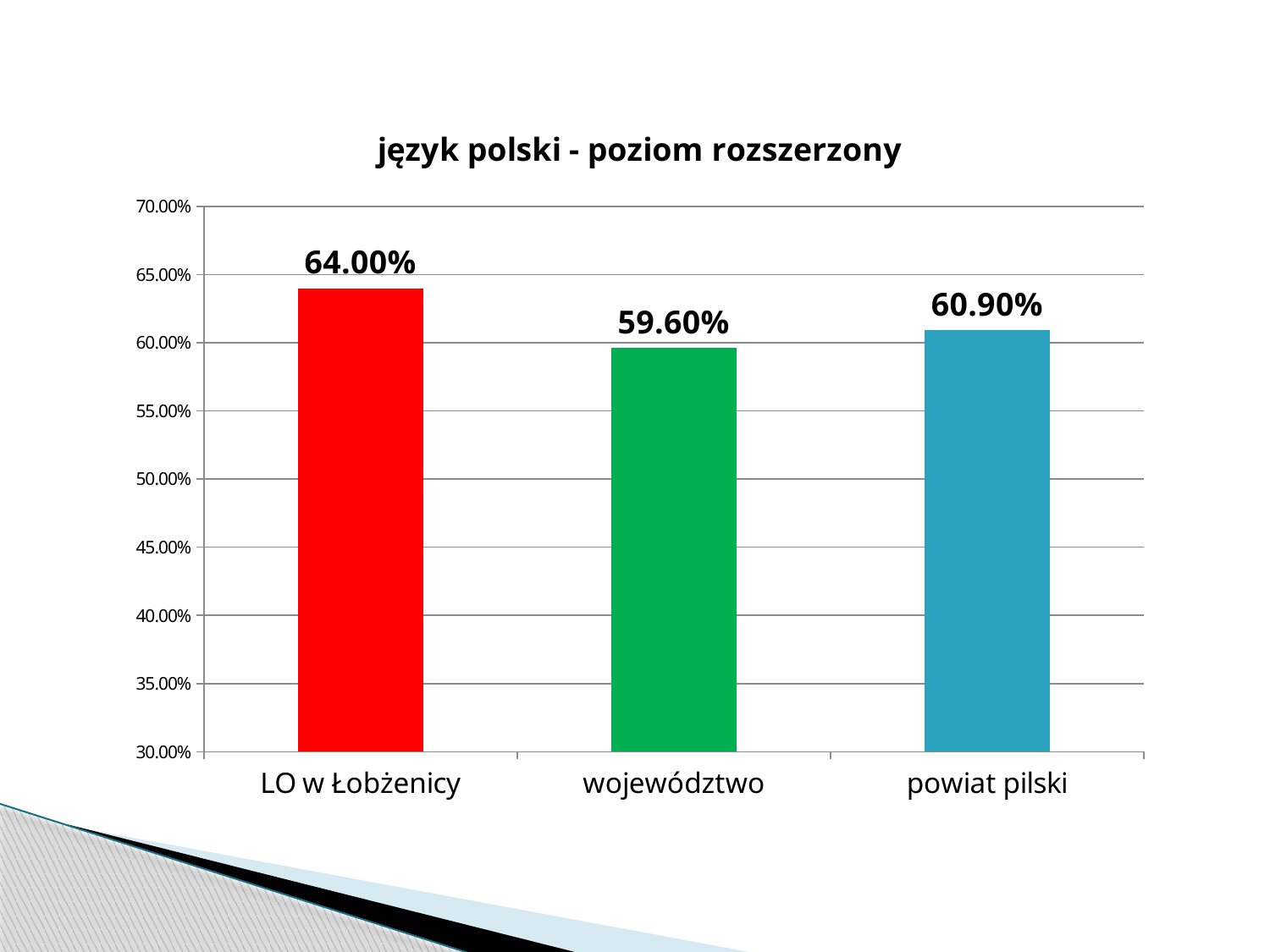
Which is larger, the value for powiat pilski or the value for województwo? powiat pilski Which category has the highest value? LO w Łobżenicy What is the difference between the values for LO w Łobżenicy and województwo? 4.40% Is the value for województwo greater or less than 60.00%? less How many categories are shown on the chart? 3 Which category has the lowest value? województwo What is the title of the chart? język polski - poziom rozszerzony What is the difference between the values for powiat pilski and województwo? 1.30% What is the value for województwo? 59.60% What is the value for powiat pilski? 60.90% What is the value for LO w Łobżenicy? 64.00% What kind of chart is shown on the slide? bar chart